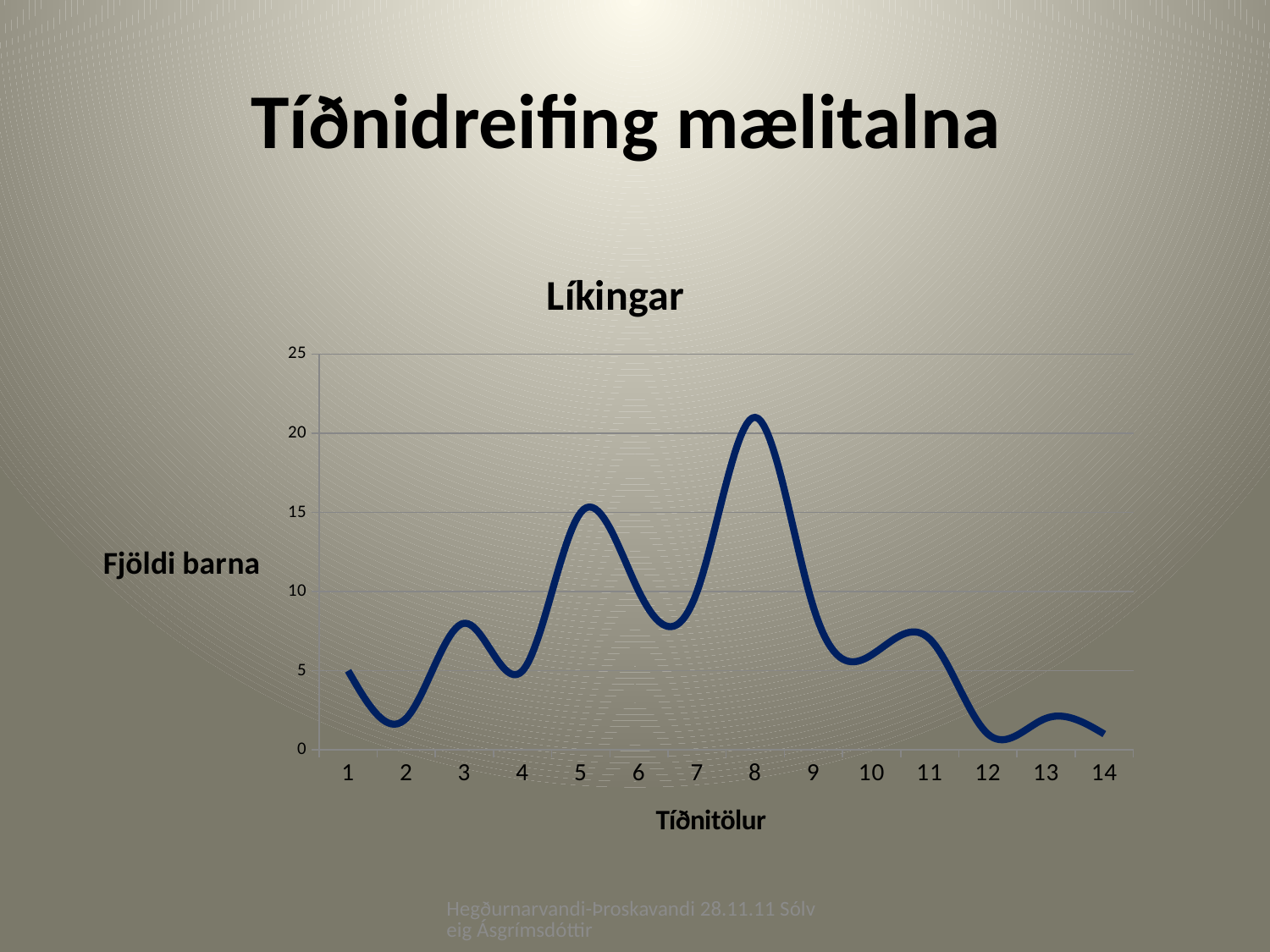
At which x value (Tíðnitölur) does the line reach its highest point? 8 Do the values rise or fall along the x axis from 8 to 12? fall Which has the larger value, x = 5 or x = 3? 5 Is the value at x = 12 greater or less than 5? less What is the title of the chart? Líkingar Is the value at x = 8 greater or less than 20? greater How many points are plotted along the x axis? 14 Is the value at x = 5 greater or less than 10? greater What kind of chart is shown on the slide? line chart What is the label on the x axis of the chart? Tíðnitölur